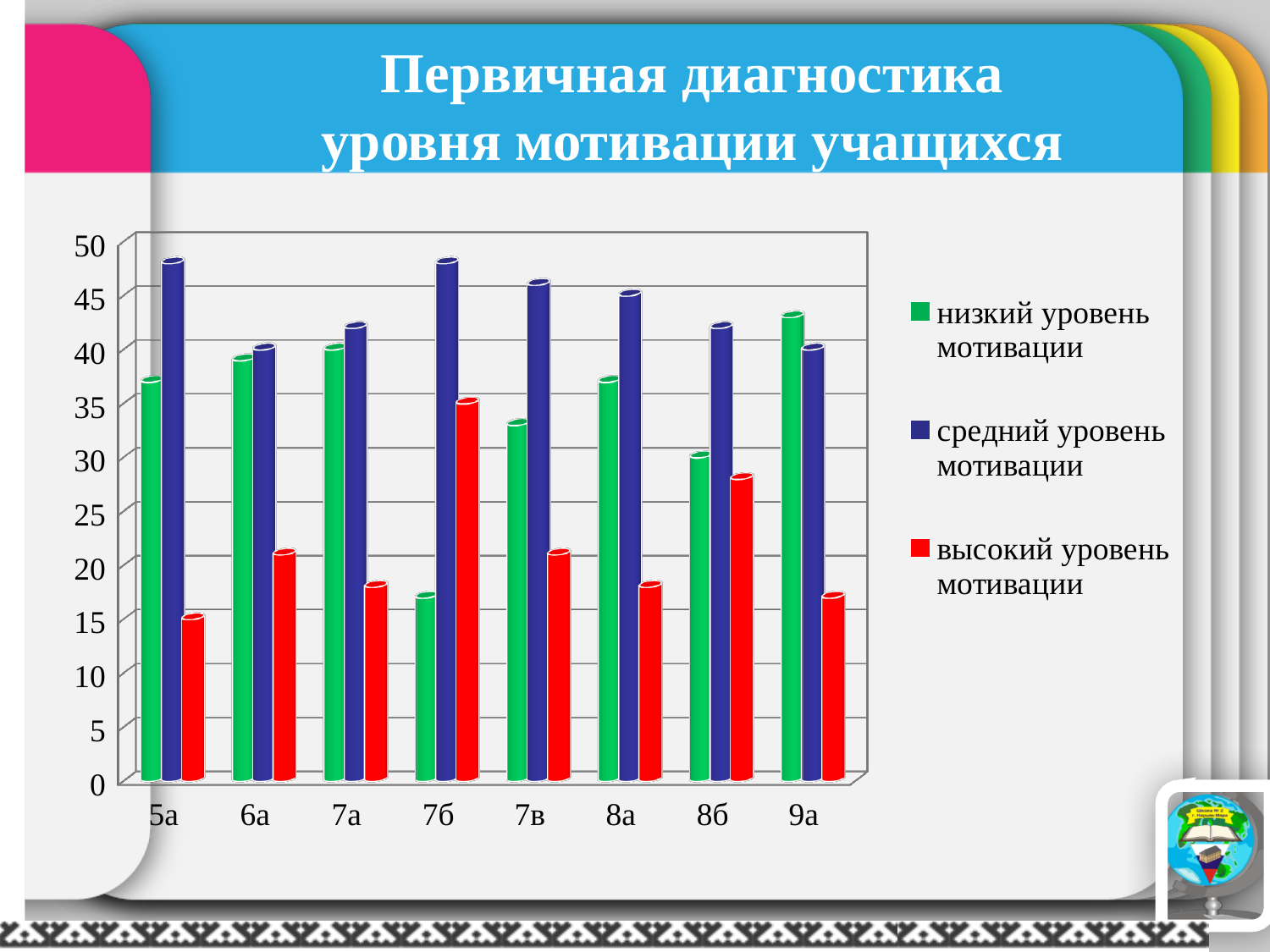
What is the title of the slide containing the chart? Первичная диагностика уровня мотивации учащихся Is the value for 'средний уровень мотивации' in class 5а greater or less than 45? greater Is the value for 'низкий уровень мотивации' in class 7б greater or less than 20? less How many series does the chart legend list? 3 Is the value for 'высокий уровень мотивации' in class 7б greater or less than 30? greater How many classes (categories) are shown on the x axis of the chart? 8 In class 7б, which is larger: 'средний уровень мотивации' or 'высокий уровень мотивации'? средний уровень мотивации Which class has the highest value for 'высокий уровень мотивации'? 7б Which class has the lowest value for 'низкий уровень мотивации'? 7б What kind of chart is shown on the slide? bar chart Which colour represents 'высокий уровень мотивации' in the chart? red